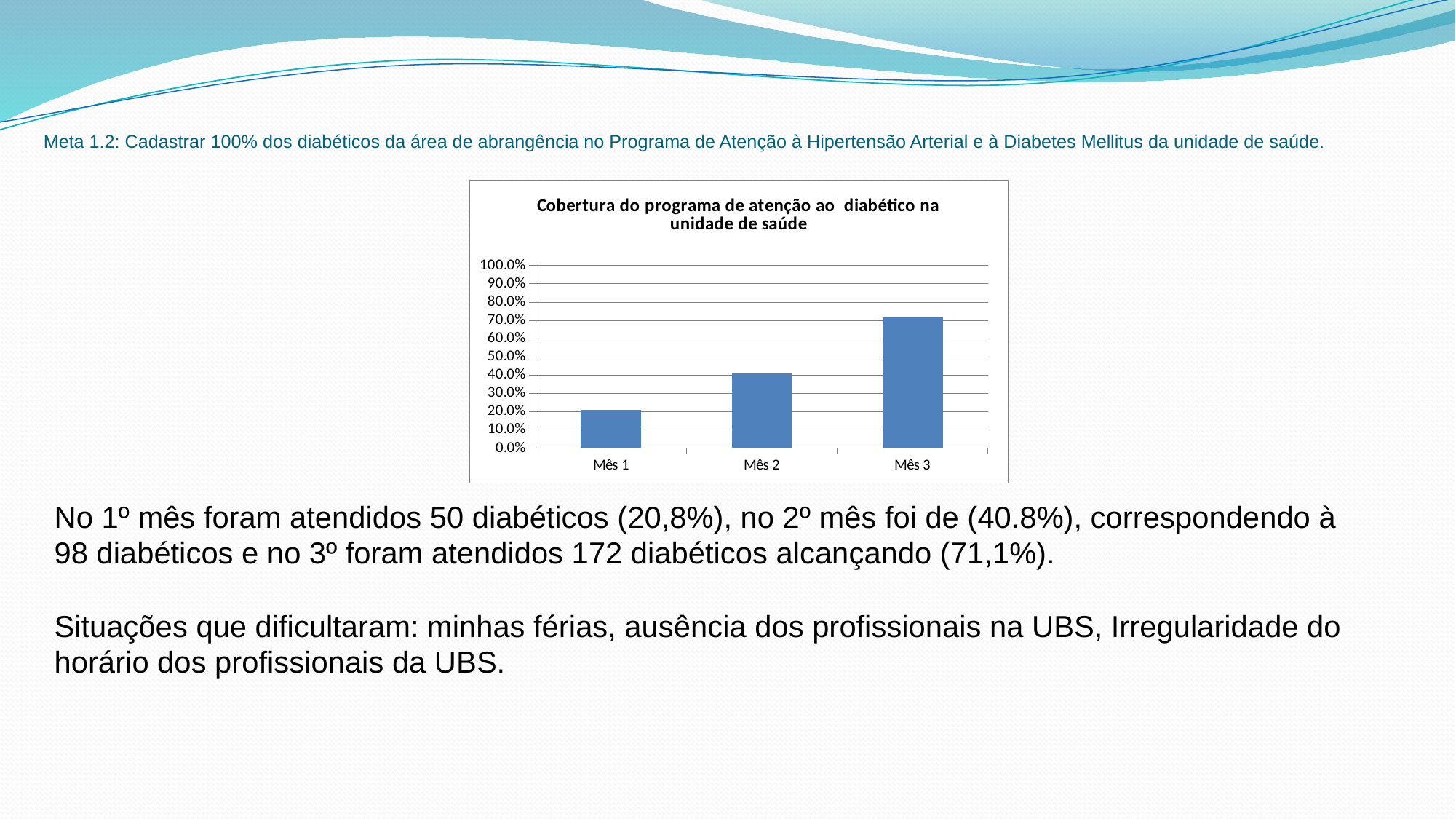
Is the value for Mês 2 greater or less than 30.0%? greater Is the value for Mês 3 greater or less than 80.0%? less What is the maximum value shown on the y axis of the chart? 100.0% Which is larger, the value for Mês 2 or the value for Mês 1? Mês 2 What is the title of the chart? Cobertura do programa de atenção ao diabético na unidade de saúde How many categories are shown on the x axis of the chart? 3 Is the value for Mês 1 greater or less than 30.0%? less Which month has the lowest bar in the chart? Mês 1 What kind of chart is shown on the slide? bar chart Which month has the highest bar in the chart? Mês 3 Do the values rise or fall from Mês 1 to Mês 3? rise